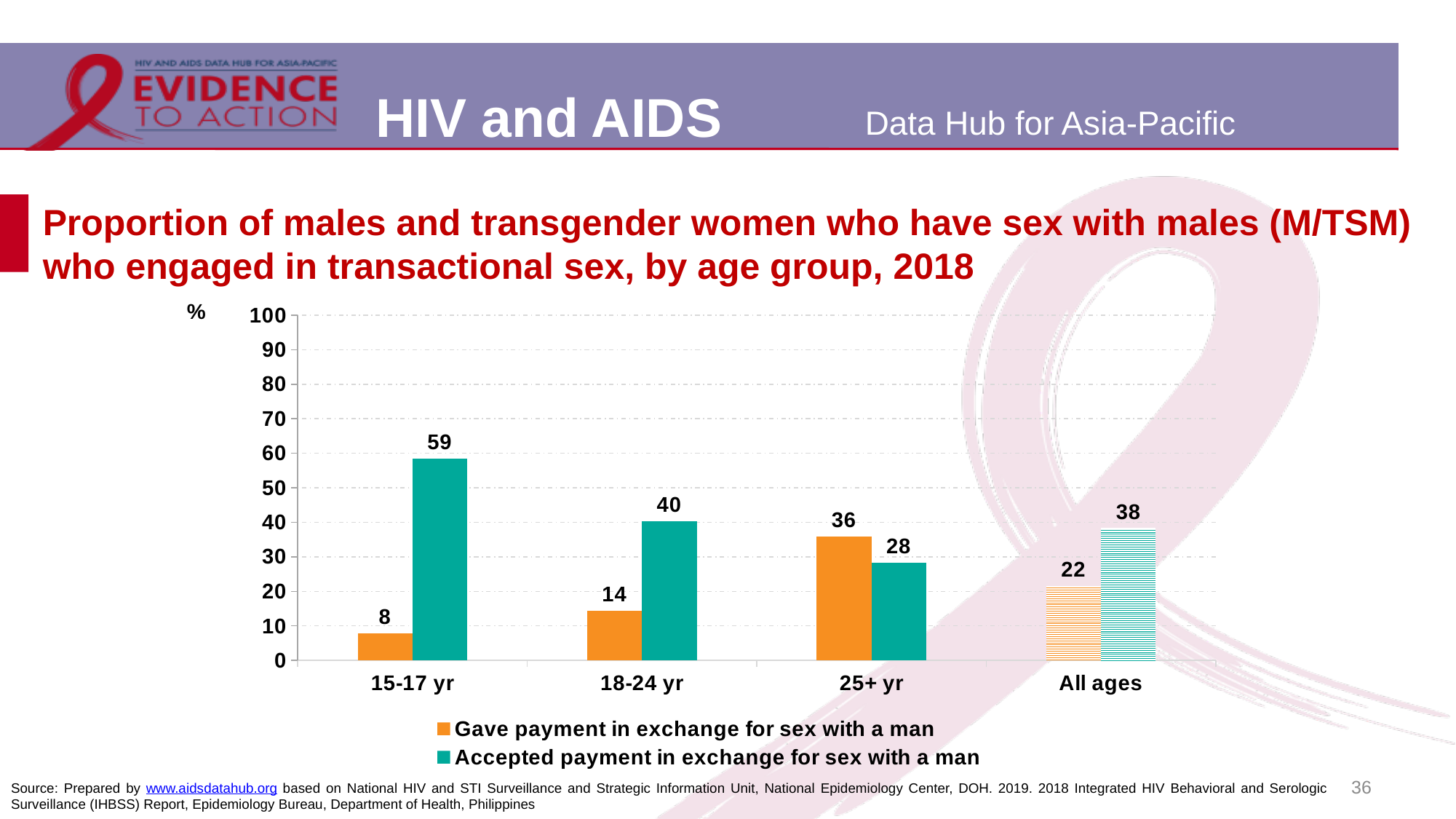
How many series does the legend list? 2 How many age group categories are shown on the x axis? 4 What is the difference between 'Accepted payment' and 'Gave payment' in the 18-24 yr age group? 26 Does the value for 'Gave payment in exchange for sex with a man' rise or fall from 15-17 yr to 25+ yr? Rise Is the value for 'Accepted payment in exchange for sex with a man' for All ages greater or less than 30? greater In the 25+ yr age group, which is larger: 'Gave payment in exchange for sex with a man' or 'Accepted payment in exchange for sex with a man'? Gave payment in exchange for sex with a man What is the value for 'Accepted payment in exchange for sex with a man' in the 15-17 yr age group? 59 Which age group has the highest value for 'Accepted payment in exchange for sex with a man'? 15-17 yr What is the value for 'Gave payment in exchange for sex with a man' for All ages? 22 What kind of chart is shown on the slide? Bar chart Which age group has the lowest value for 'Gave payment in exchange for sex with a man'? 15-17 yr What is the value for 'Gave payment in exchange for sex with a man' in the 25+ yr age group? 36